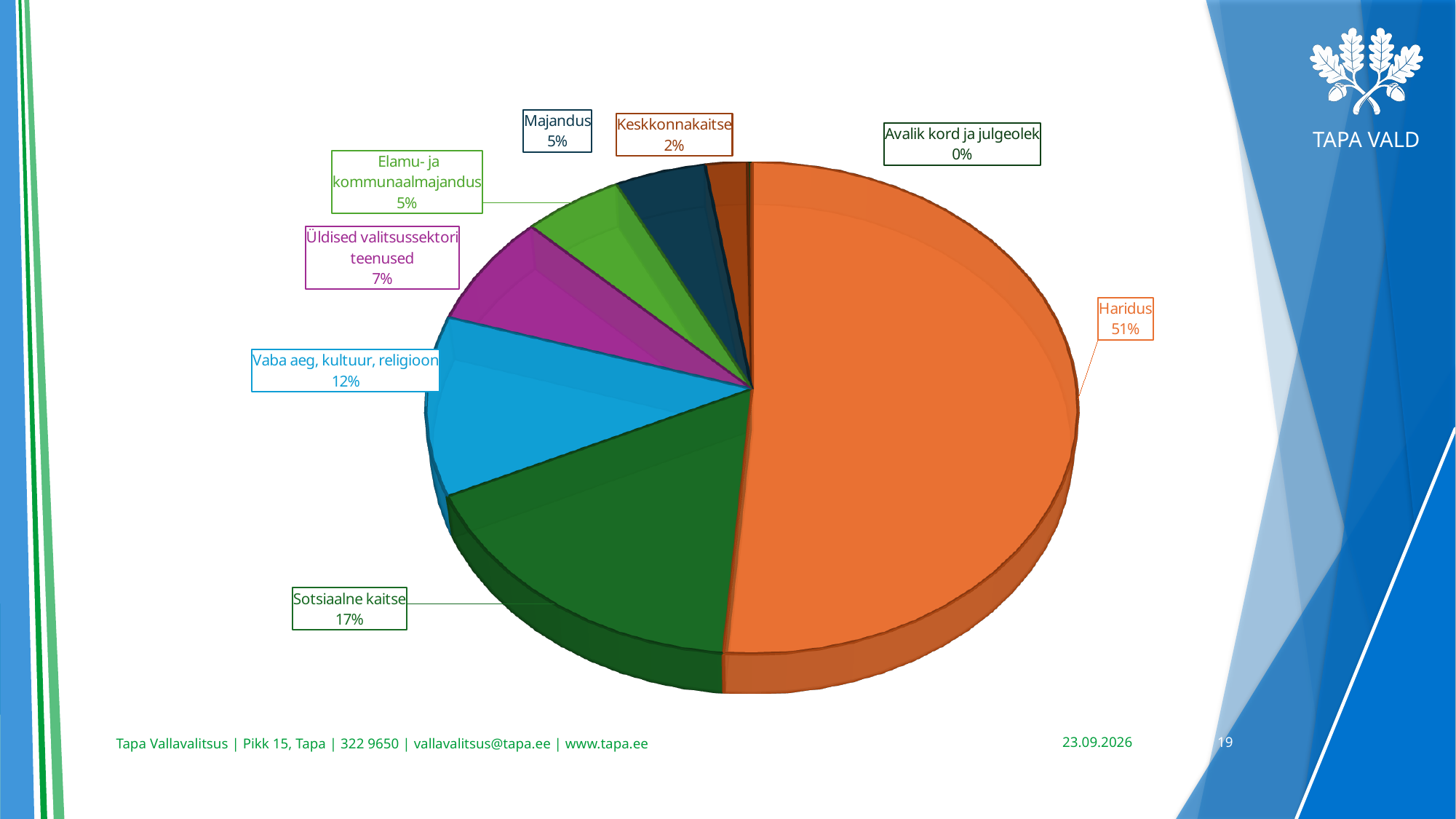
What is the value shown for Keskkonnakaitse? 2% Which category has the smallest share of the pie? Avalik kord ja julgeolek What kind of chart is shown on the slide? pie chart How many categories are shown in the pie chart? 8 What is the value shown for Vaba aeg, kultuur, religioon? 12% What is the value shown for Avalik kord ja julgeolek? 0% What share of the pie does Sotsiaalne kaitse have? 17% What is the difference in percentage points between Haridus and Sotsiaalne kaitse? 34 What is the value shown for Üldised valitsussektori teenused? 7% Which is larger, the share for Vaba aeg, kultuur, religioon or the share for Üldised valitsussektori teenused? Vaba aeg, kultuur, religioon What share of the pie does Haridus have? 51% Which category has the largest slice of the pie? Haridus